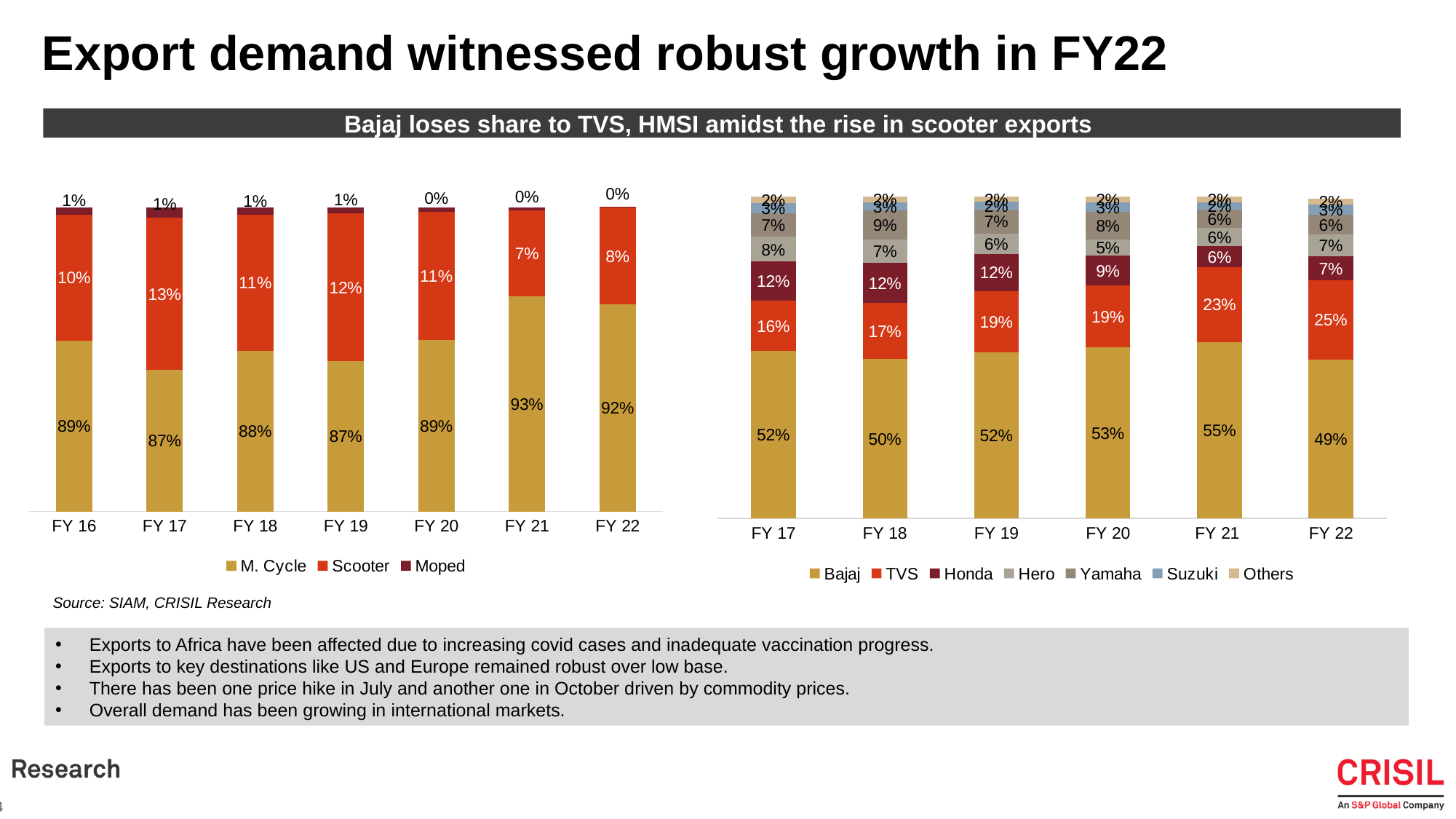
In the left chart, which fiscal year has the lowest Scooter share? FY 21 In the right chart, does TVS's share rise or fall from FY 17 to FY 22? rise In the left chart, how many series does the legend list? 3 In the left chart, what is the Scooter share in FY 17? 13% In the right chart, how many series does the legend list? 7 In the left chart, what is the M. Cycle share in FY 21? 93% In the right chart, by how many percentage points did TVS's share change from FY 17 to FY 22? 9 percentage points In the right chart, which fiscal year has the highest Bajaj share? FY 21 In the left chart, which fiscal year has the highest M. Cycle share? FY 21 In the left chart, how many fiscal years are shown on the x axis? 7 In the right chart, what is TVS's share in FY 21? 23% In the right chart, what is Bajaj's share in FY 22? 49%